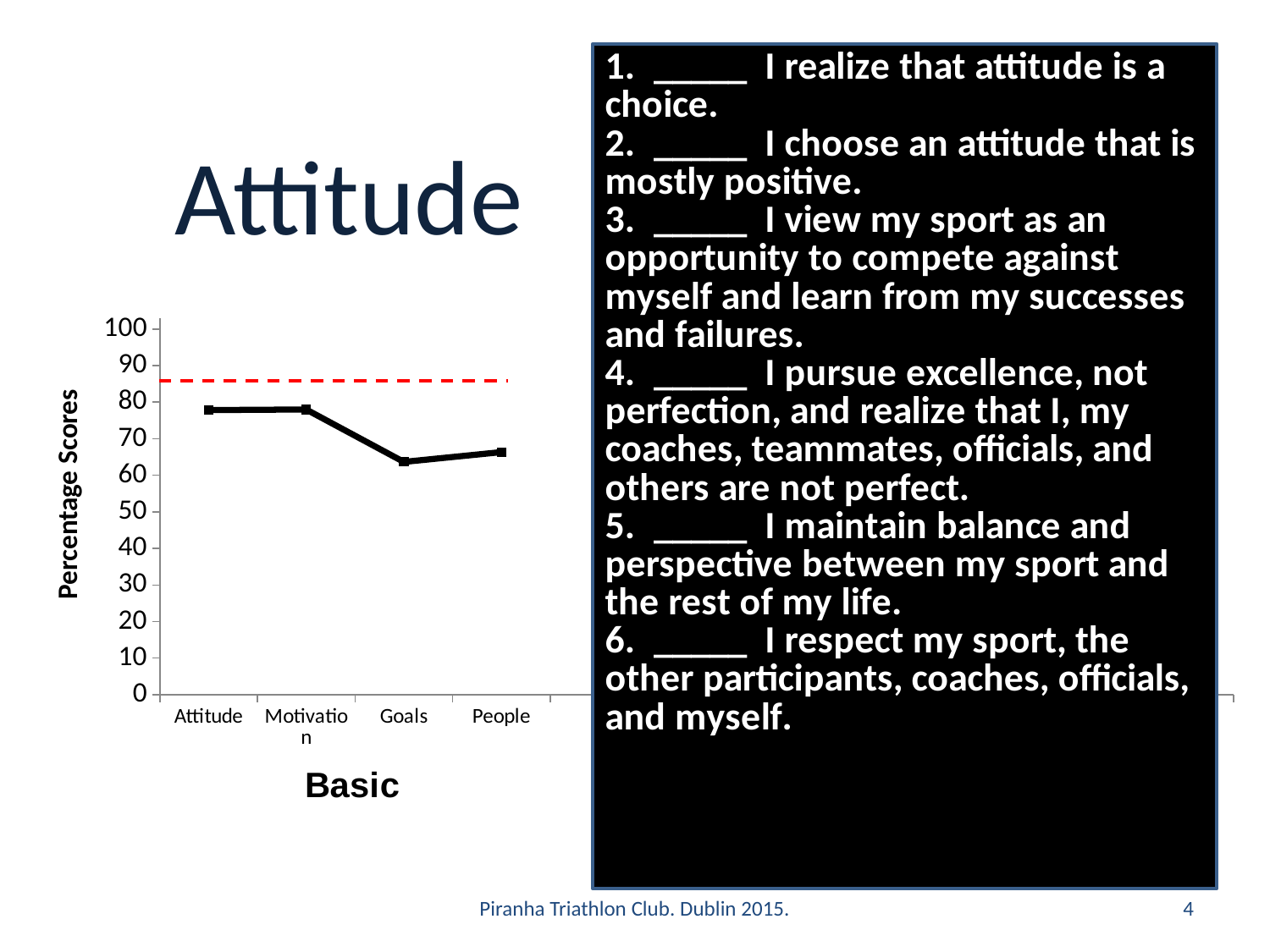
Is the value for Goals greater or less than 70? less Does the line rise or fall from Motivation to Goals? fall Is the value for Attitude greater or less than 70? greater Which is larger, the value for Attitude or the value for Goals? Attitude Among Attitude, Motivation, Goals and People, which category has the lowest value? Goals Is the value for Goals greater or less than 50? greater Which is larger, the value for Motivation or the value for People? Motivation What is the label on the vertical axis of the chart? Percentage Scores What is the title shown below the horizontal axis of the chart? Basic What kind of chart is shown on the slide? line chart